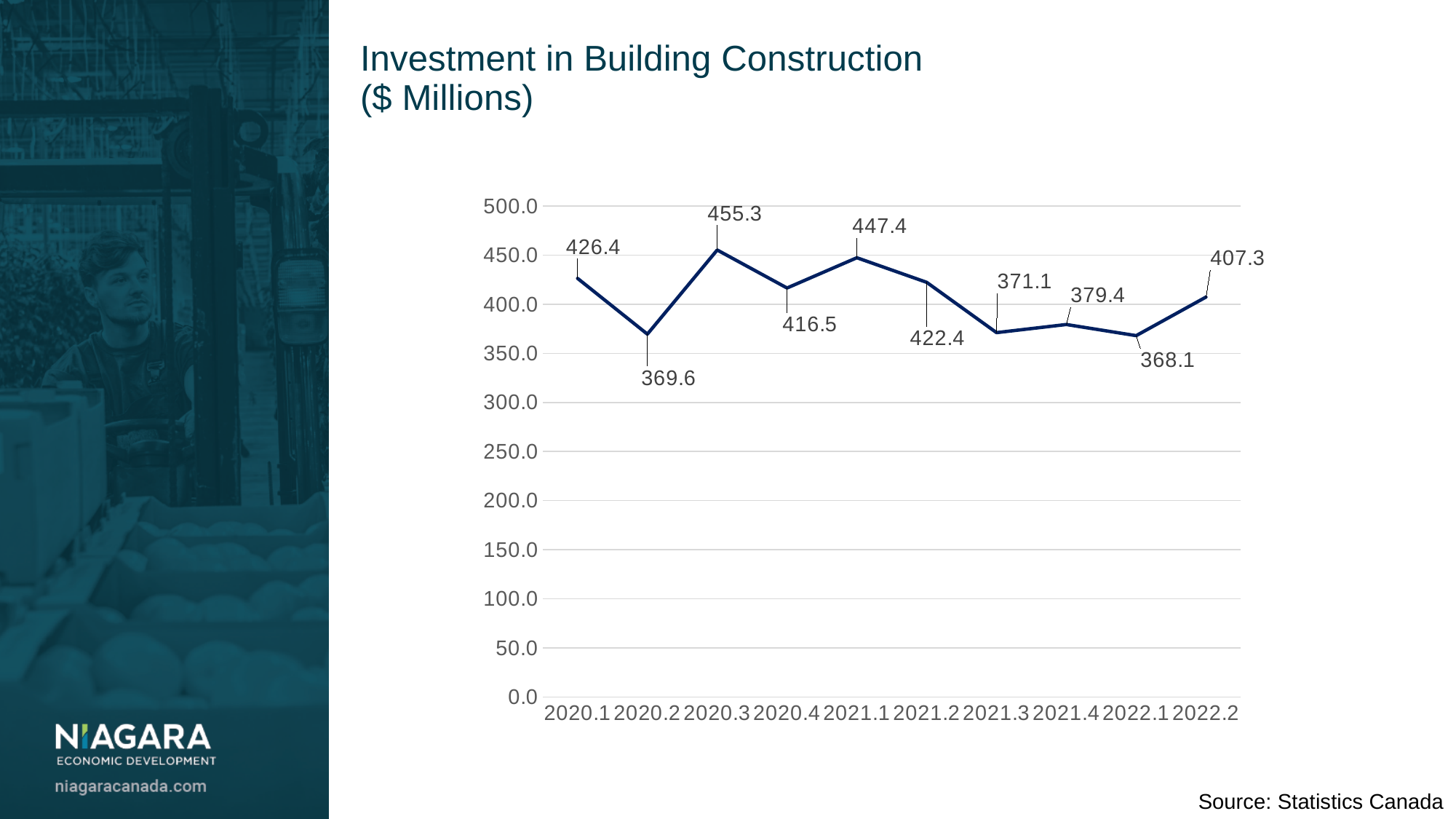
What is the difference between the values for 2020.3 and 2020.2? 85.7 What is the value plotted for 2022.2? 407.3 How many quarters are plotted on the chart? 10 What is the value plotted for 2021.1? 447.4 Which quarter has the lowest investment in building construction? 2022.1 Is the value for 2021.3 greater or less than 400.0? less What is the investment in building construction for 2020.3? 455.3 Which quarter has the highest investment in building construction? 2020.3 Which is larger, the value for 2020.1 or the value for 2022.2? 2020.1 What is the difference between the values for 2021.1 and 2021.2? 25.0 What is the title of the chart? Investment in Building Construction ($ Millions) What type of chart is shown on the slide? line chart